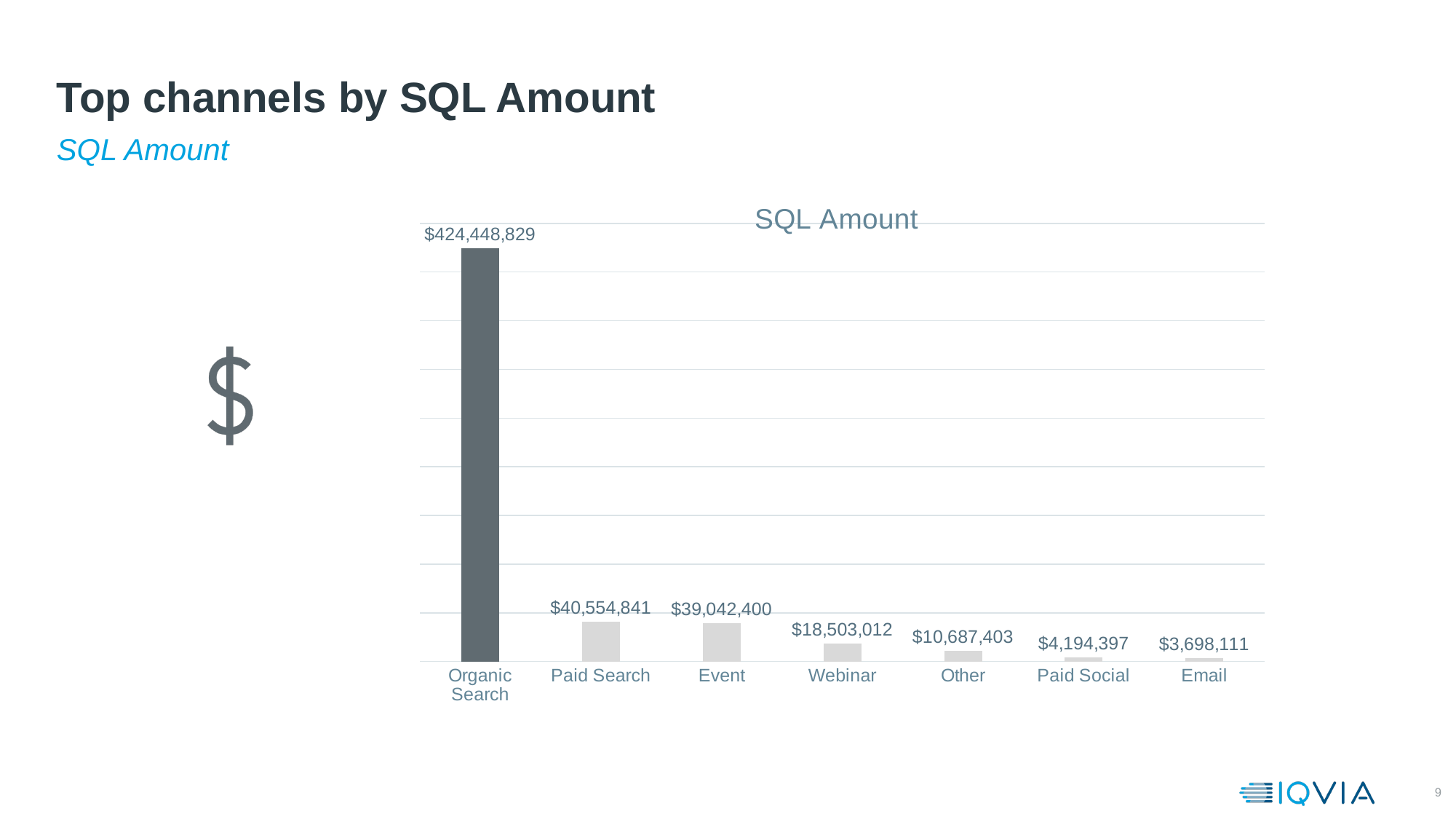
Which channel has the highest SQL Amount? Organic Search What type of chart is shown on the slide? Bar chart How many channels are shown in the chart? 7 Which has a larger SQL Amount, Paid Search or Event? Paid Search Do the SQL Amount values rise or fall from left to right across the channels? Fall What is the SQL Amount for Webinar? $18,503,012 What is the difference in SQL Amount between Webinar and Other? $7,815,609 What is the difference in SQL Amount between Paid Search and Event? $1,512,441 What is the SQL Amount for Organic Search? $424,448,829 Which channel has the lowest SQL Amount? Email What is the SQL Amount for Paid Social? $4,194,397 What is the SQL Amount for Email? $3,698,111